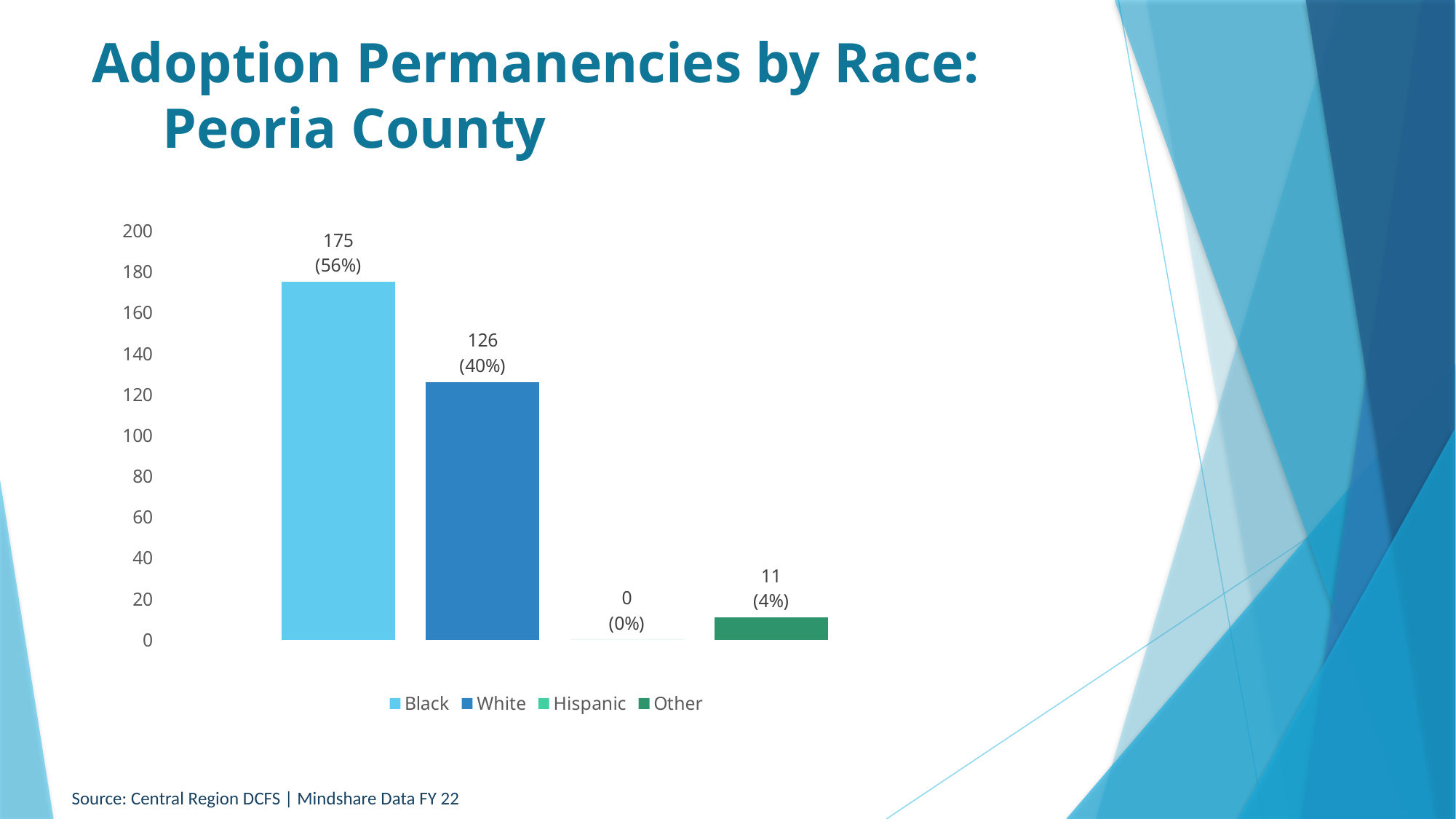
What is the title of the chart on the slide? Adoption Permanencies by Race: Peoria County How many adoption permanencies are shown for Black in Peoria County? 175 Which race has the highest number of adoption permanencies? Black What is the value shown for Other? 11 Which race has the lowest number of adoption permanencies? Hispanic What is the value shown for Hispanic? 0 Which is larger, the value for White or the value for Other? White What kind of chart is shown on the slide? Bar chart What is the difference between the values for Black and White? 49 How many series does the legend list? 4 Is the value for White greater or less than 140? less What percentage of adoption permanencies is shown for White? 40%